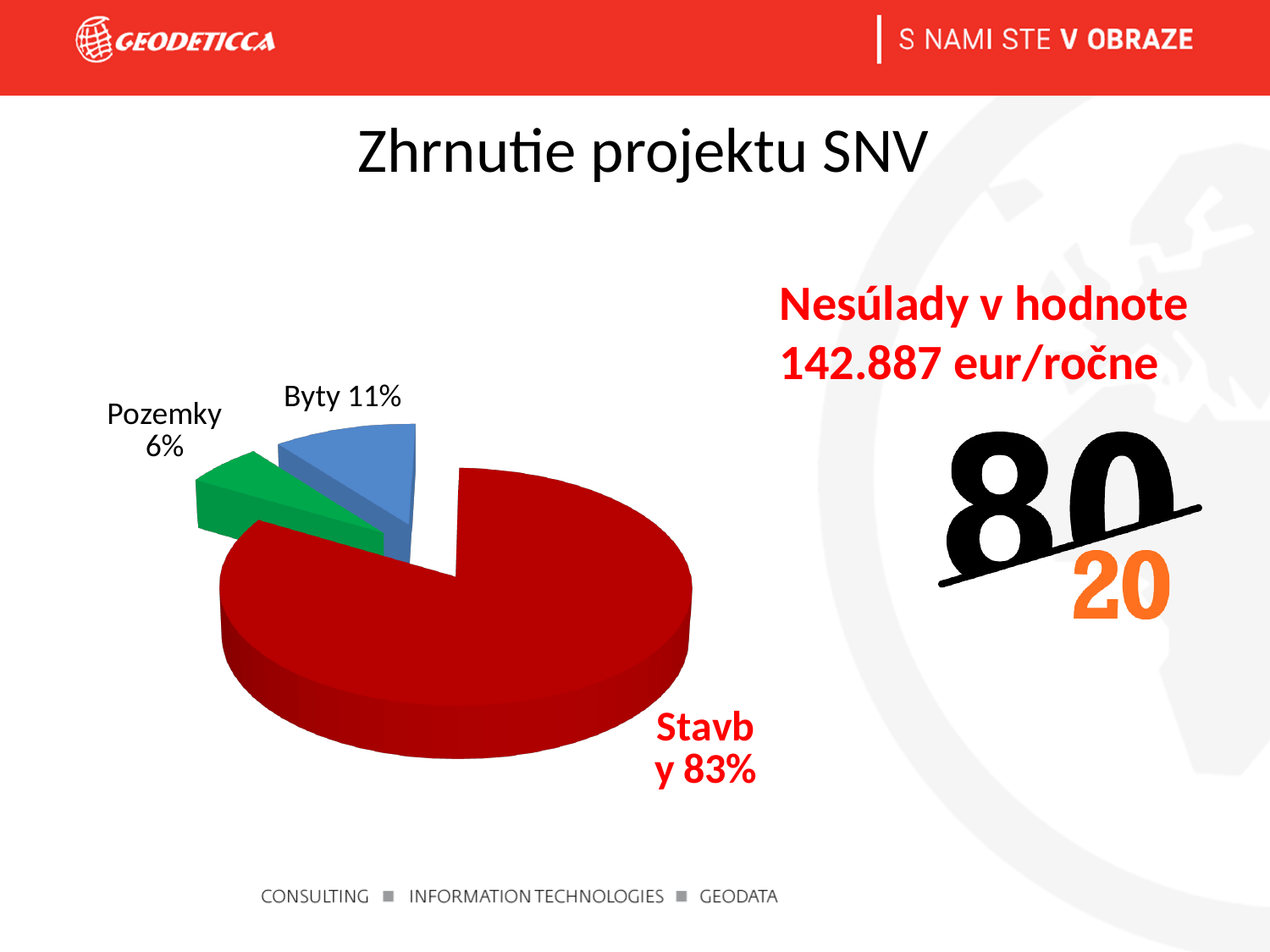
What is the difference in percentage points between the Stavby share and the Byty share? 72 Which is larger, the share for Byty or the share for Pozemky? Byty What share of the pie does Byty have? 11% Which category has the largest slice of the pie? Stavby How many slices does the pie chart have? 3 What share of the pie does Stavby have? 83% What is the difference in percentage points between the Byty share and the Pozemky share? 5 Which category has the smallest slice of the pie? Pozemky What share of the pie does Pozemky have? 6% What colour is the Stavby slice of the pie? red What colour is the Pozemky slice of the pie? green What kind of chart is shown on the slide? pie chart